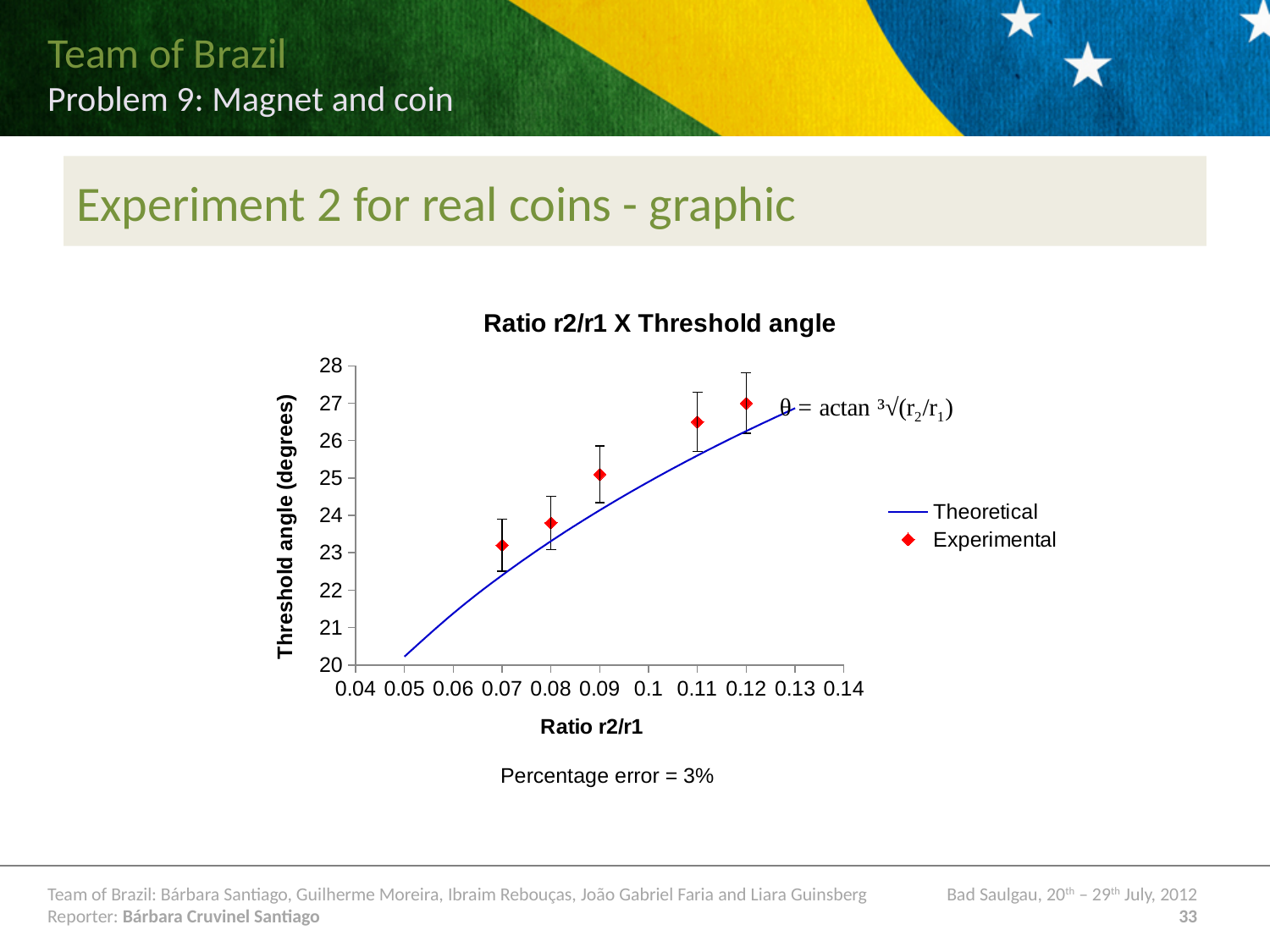
What is the title of the chart? Ratio r2/r1 X Threshold angle What is the label of the y axis? Threshold angle (degrees) At which ratio r2/r1 is the experimental threshold angle highest? 0.12 Does the threshold angle rise or fall as the ratio r2/r1 increases? rises Is the experimental threshold angle at ratio 0.07 greater or less than 24? less At which ratio r2/r1 is the experimental threshold angle lowest? 0.07 How many experimental data points are plotted on the chart? 5 What are the two series named in the legend? Theoretical and Experimental Is the experimental threshold angle at ratio 0.11 greater or less than 26? greater Which has the larger experimental threshold angle: ratio 0.09 or ratio 0.11? 0.11 How many series does the chart legend list? 2